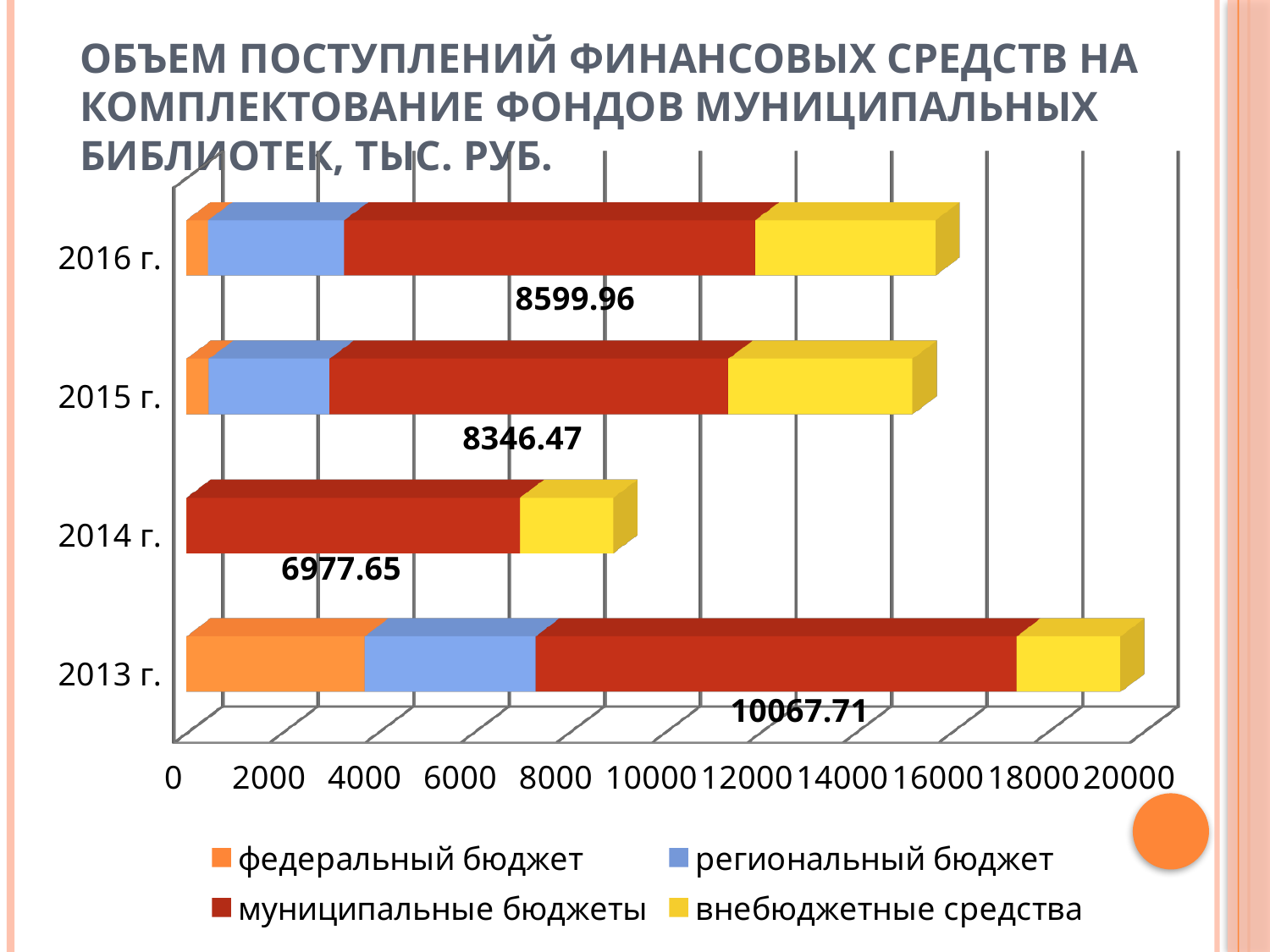
What is the value of the municipal budgets (муниципальные бюджеты) segment for 2014 г.? 6977.65 What is the value of the municipal budgets (муниципальные бюджеты) segment for 2016 г.? 8599.96 Is the federal budget (федеральный бюджет) value for 2013 г. greater or less than 2000? greater How many years are shown on the chart? 4 Which year has the lowest labelled municipal budgets value? 2014 г. What is the difference between the municipal budgets values for 2013 г. and 2014 г.? 3090.06 How many series does the legend list? 4 What kind of chart is shown on the slide? Stacked bar chart Which year has the larger municipal budgets value, 2015 г. or 2016 г.? 2016 г. Is the total length of the stacked bar for 2014 г. greater or less than 10000? less What is the value of the municipal budgets (муниципальные бюджеты) segment for 2013 г.? 10067.71 Which year has the highest labelled municipal budgets value? 2013 г.